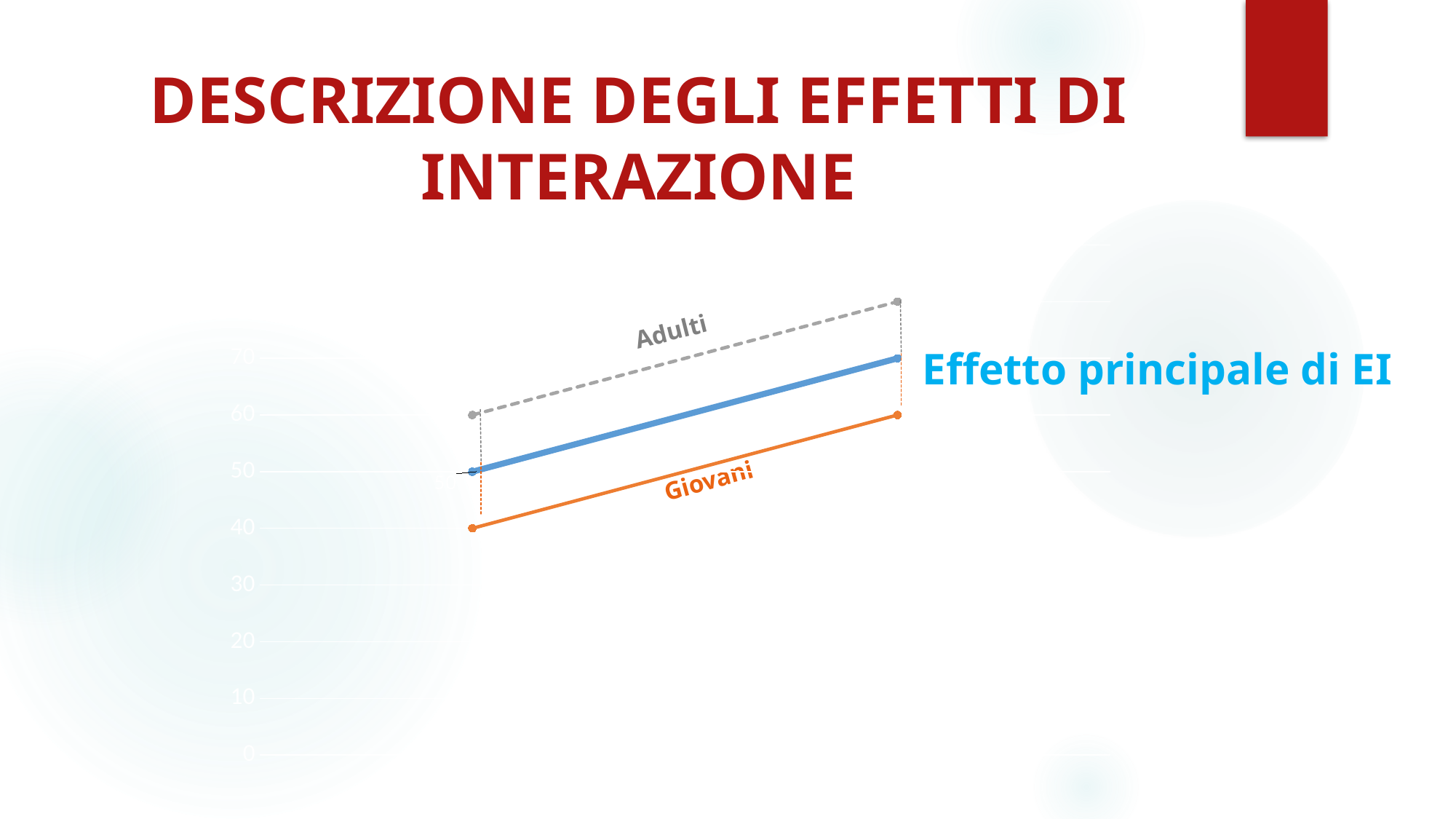
What colour is the Giovani line? orange Do the lines rise or fall from left to right? rise Is the left-hand end of the Giovani line greater or less than 50? less What kind of chart is shown on the slide? line chart What value does the Adulti line start at on the left? 60 What label is given to the blue line on the chart? Effetto principale di EI How many lines are plotted on the chart? 3 Which line is the lowest on the chart? Giovani Which line is the highest on the chart, Adulti or Giovani? Adulti Is the right-hand end of the Adulti line greater or less than 70? greater At the left-hand end of the chart, which is larger, Adulti or Giovani? Adulti What value does the Giovani line start at on the left? 40